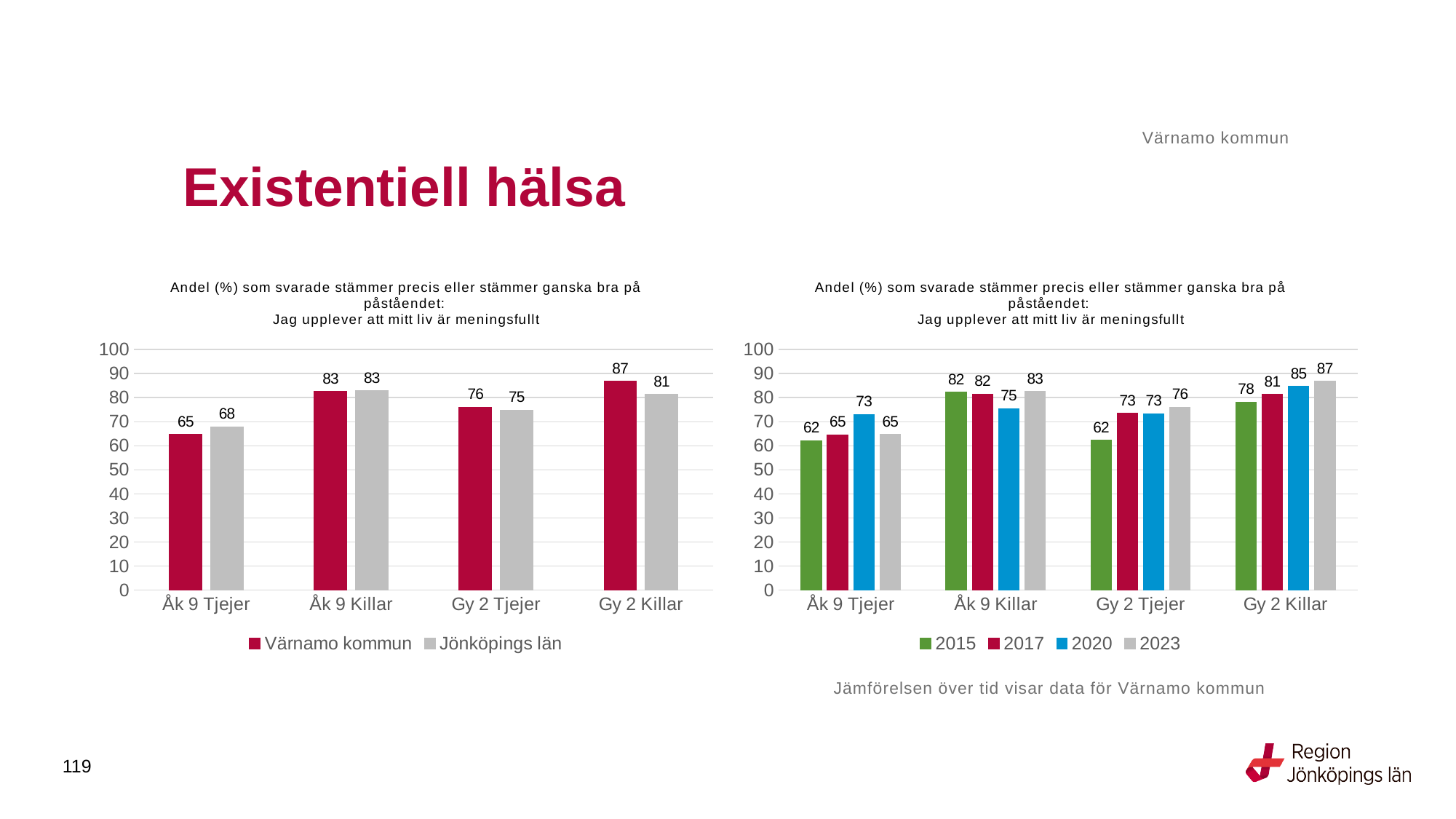
In the left chart, which category has the highest value for Värnamo kommun? Gy 2 Killar In the left chart, what is the value for Jönköpings län for Gy 2 Killar? 81 In the left chart, which category has the lowest value for Jönköpings län? Åk 9 Tjejer In the right chart, what is the value for 2015 for Gy 2 Tjejer? 62 In the right chart, what is the difference between the 2023 and 2015 values for Gy 2 Killar? 9 In the right chart, which is larger for Åk 9 Tjejer: the 2020 value or the 2023 value? 2020 In the left chart, what is the difference between Värnamo kommun and Jönköpings län for Gy 2 Killar? 6 In the right chart, how many series does the legend list? 4 In the left chart, how many series does the legend list? 2 In the right chart, what is the value for 2020 for Gy 2 Killar? 85 What kind of chart is the right chart? Bar chart In the left chart, what is the value for Värnamo kommun for Åk 9 Tjejer? 65